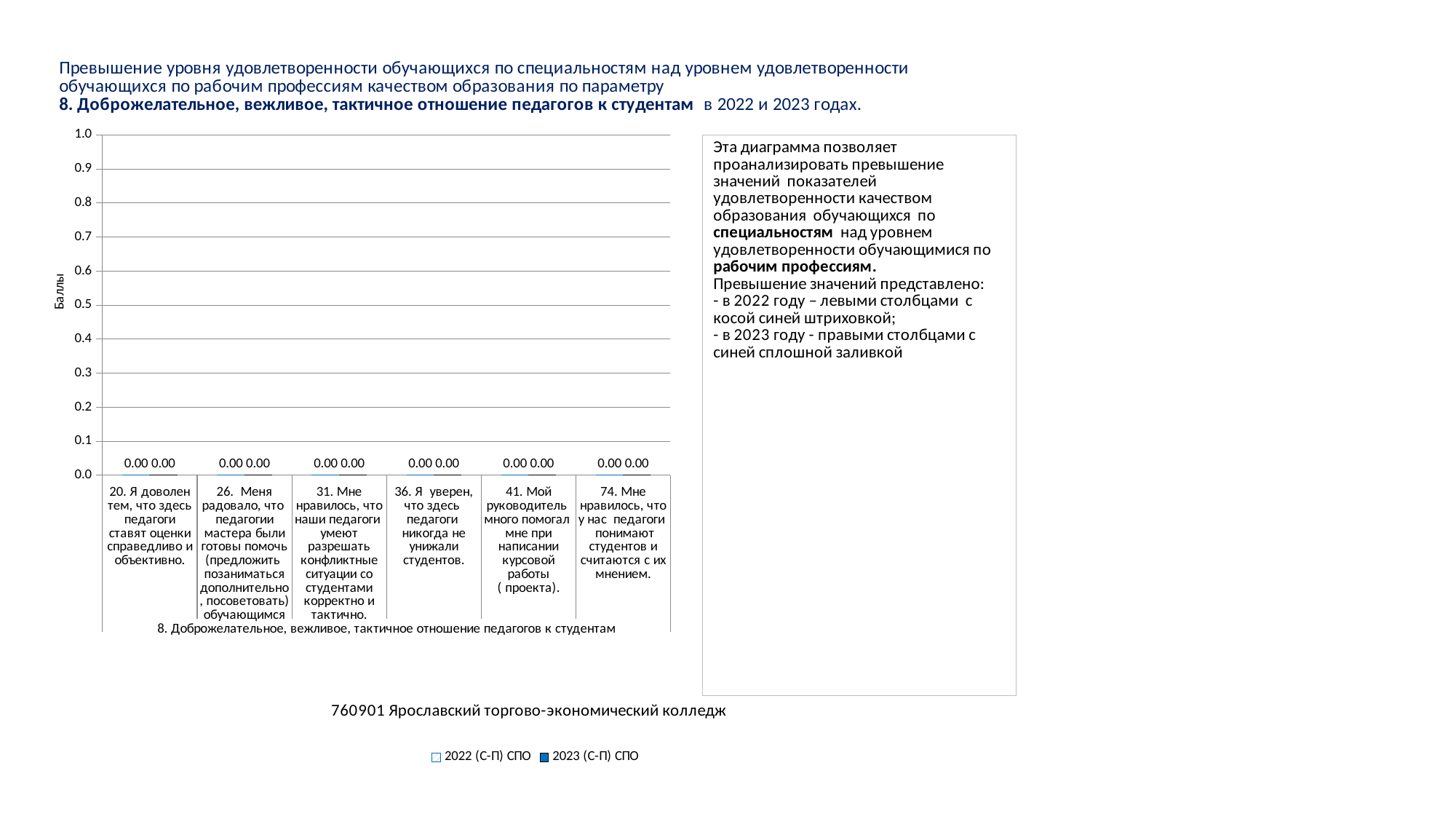
What is the value for the 2022 (С-П) СПО series for category 74 ("Мне нравилось, что у нас педагоги понимают студентов и считаются с их мнением")? 0.00 What is the label of the vertical axis of the chart? Баллы What kind of chart is shown on the slide? bar chart What is the difference between the 2022 (С-П) СПО and 2023 (С-П) СПО values for category 31 ("Мне нравилось, что наши педагоги умеют разрешать конфликтные ситуации со студентами корректно и тактично")? 0.00 What is the value for the 2023 (С-П) СПО series for category 36 ("Я уверен, что здесь педагоги никогда не унижали студентов")? 0.00 Is the value for the 2023 (С-П) СПО series for category 26 greater or less than 0.5? less How many categories are shown on the x axis of the chart? 6 What is the value for the 2023 (С-П) СПО series for category 41 ("Мой руководитель много помогал мне при написании курсовой работы (проекта)")? 0.00 How many series does the legend list? 2 What is the highest value shown on the vertical axis of the chart? 1.0 What is the value for the 2022 (С-П) СПО series for category 20 ("Я доволен тем, что здесь педагоги ставят оценки справедливо и объективно")? 0.00 What are the two series names listed in the legend? 2022 (С-П) СПО and 2023 (С-П) СПО